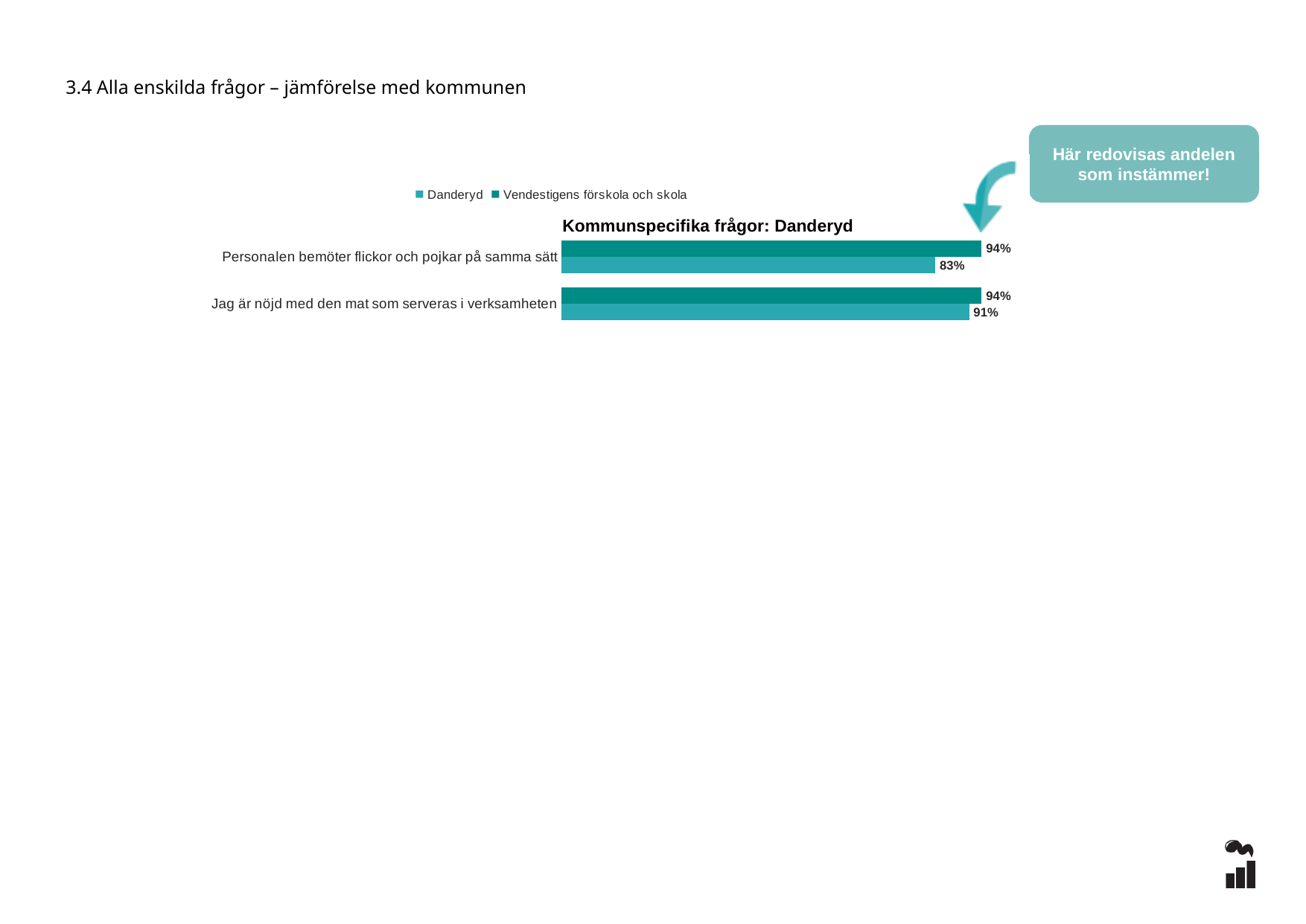
What is the value for Danderyd for 'Personalen bemöter flickor och pojkar på samma sätt'? 83% What is the value for Vendestigens förskola och skola for 'Personalen bemöter flickor och pojkar på samma sätt'? 94% What is the difference between Vendestigens förskola och skola and Danderyd for 'Personalen bemöter flickor och pojkar på samma sätt'? 11 percentage points What is the value for Vendestigens förskola och skola for 'Jag är nöjd med den mat som serveras i verksamheten'? 94% What is the title of the chart? Kommunspecifika frågor: Danderyd For 'Personalen bemöter flickor och pojkar på samma sätt', which is larger: Danderyd or Vendestigens förskola och skola? Vendestigens förskola och skola What kind of chart is shown on the slide? bar chart Which category has the lowest value for Danderyd? Personalen bemöter flickor och pojkar på samma sätt What is the value for Danderyd for 'Jag är nöjd med den mat som serveras i verksamheten'? 91% How many series does the legend list? 2 How many categories (questions) are plotted in the chart? 2 What is the difference between Vendestigens förskola och skola and Danderyd for 'Jag är nöjd med den mat som serveras i verksamheten'? 3 percentage points